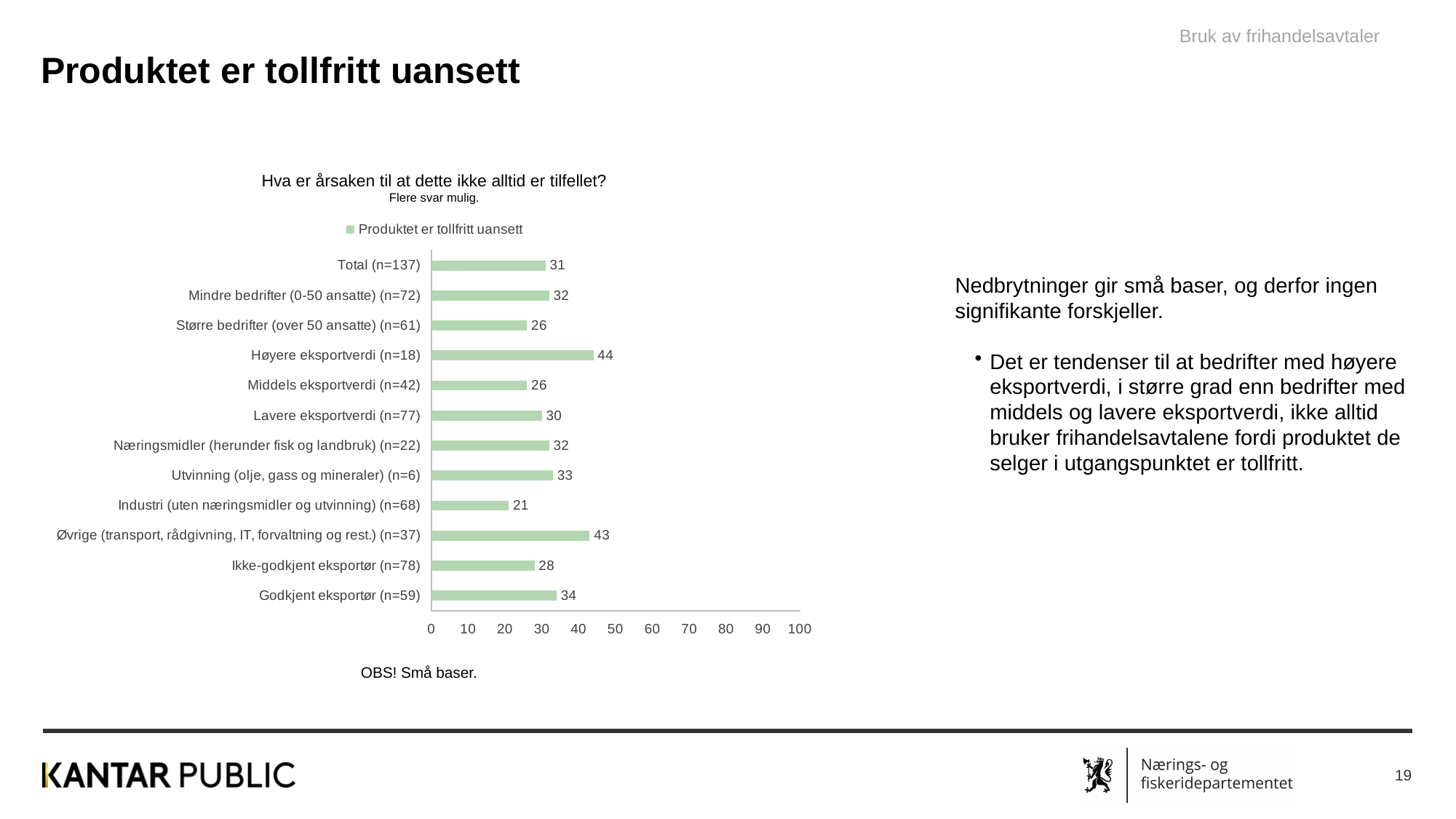
Which category has the highest value? Høyere eksportverdi (n=18) What is the value for Godkjent eksportør (n=59)? 34 How many series does the legend list? 1 What is the value for Industri (uten næringsmidler og utvinning) (n=68)? 21 How many categories are shown in the chart? 12 What is the value for Total (n=137)? 31 What is the legend entry of the chart? Produktet er tollfritt uansett What is the value for Høyere eksportverdi (n=18)? 44 Which is larger, the value for Godkjent eksportør (n=59) or Ikke-godkjent eksportør (n=78)? Godkjent eksportør (n=59) Which category has the lowest value? Industri (uten næringsmidler og utvinning) (n=68) What is the difference between the values for Høyere eksportverdi (n=18) and Middels eksportverdi (n=42)? 18 What kind of chart is shown on the slide? Bar chart